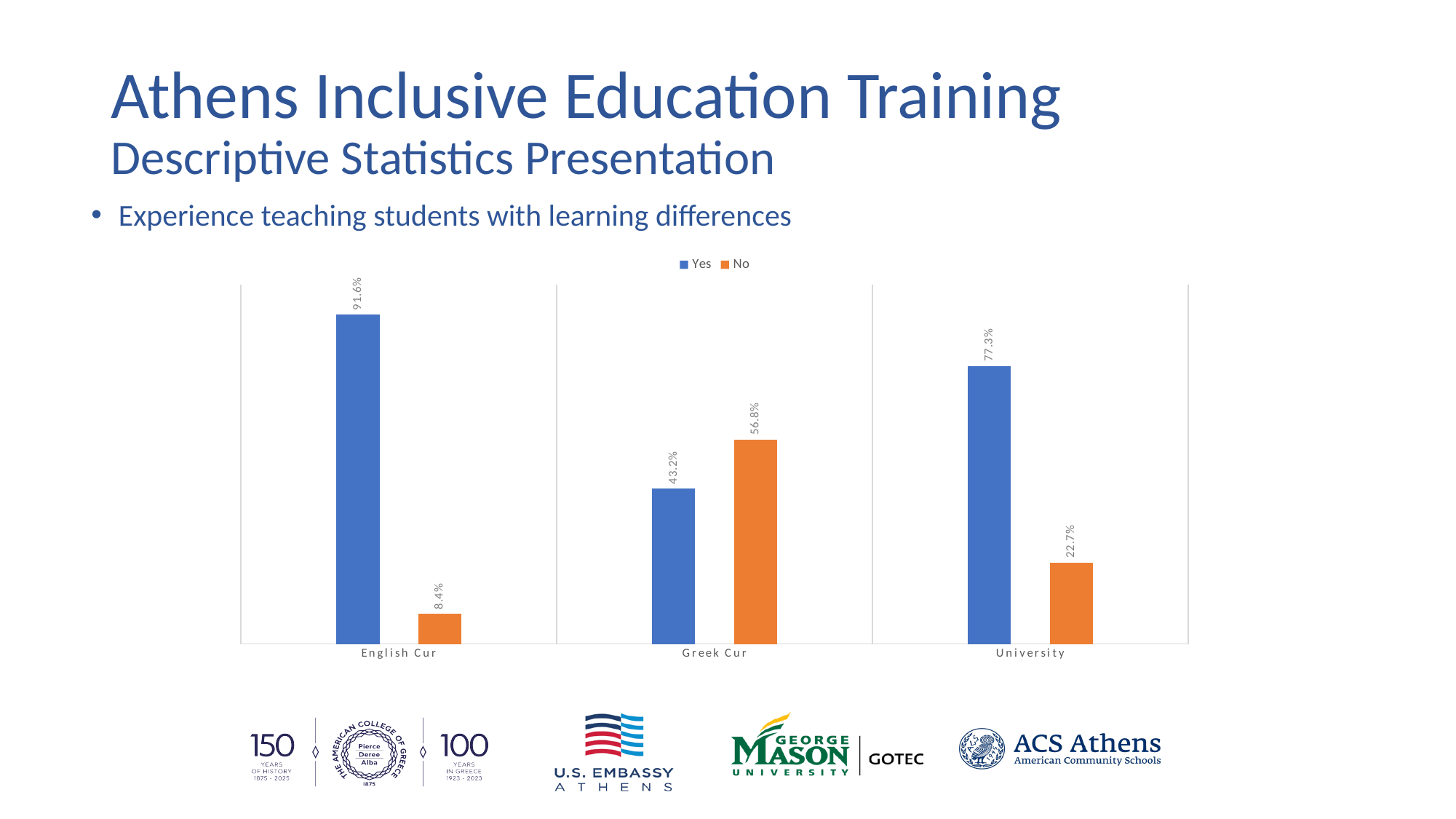
What is the difference between the 'Yes' and 'No' values for Greek Cur? 13.6% What kind of chart is shown on the slide? Bar chart How many categories are shown on the x axis? 3 Which is larger for Greek Cur, the 'Yes' value or the 'No' value? No What is the 'No' value for Greek Cur? 56.8% What is the 'No' value for University? 22.7% Which category has the highest 'Yes' value? English Cur What is the 'Yes' value for University? 77.3% What is the 'Yes' value for English Cur? 91.6% How many series does the legend list? 2 Which category has the lowest 'No' value? English Cur Which colour represents the 'No' series in the legend? Orange